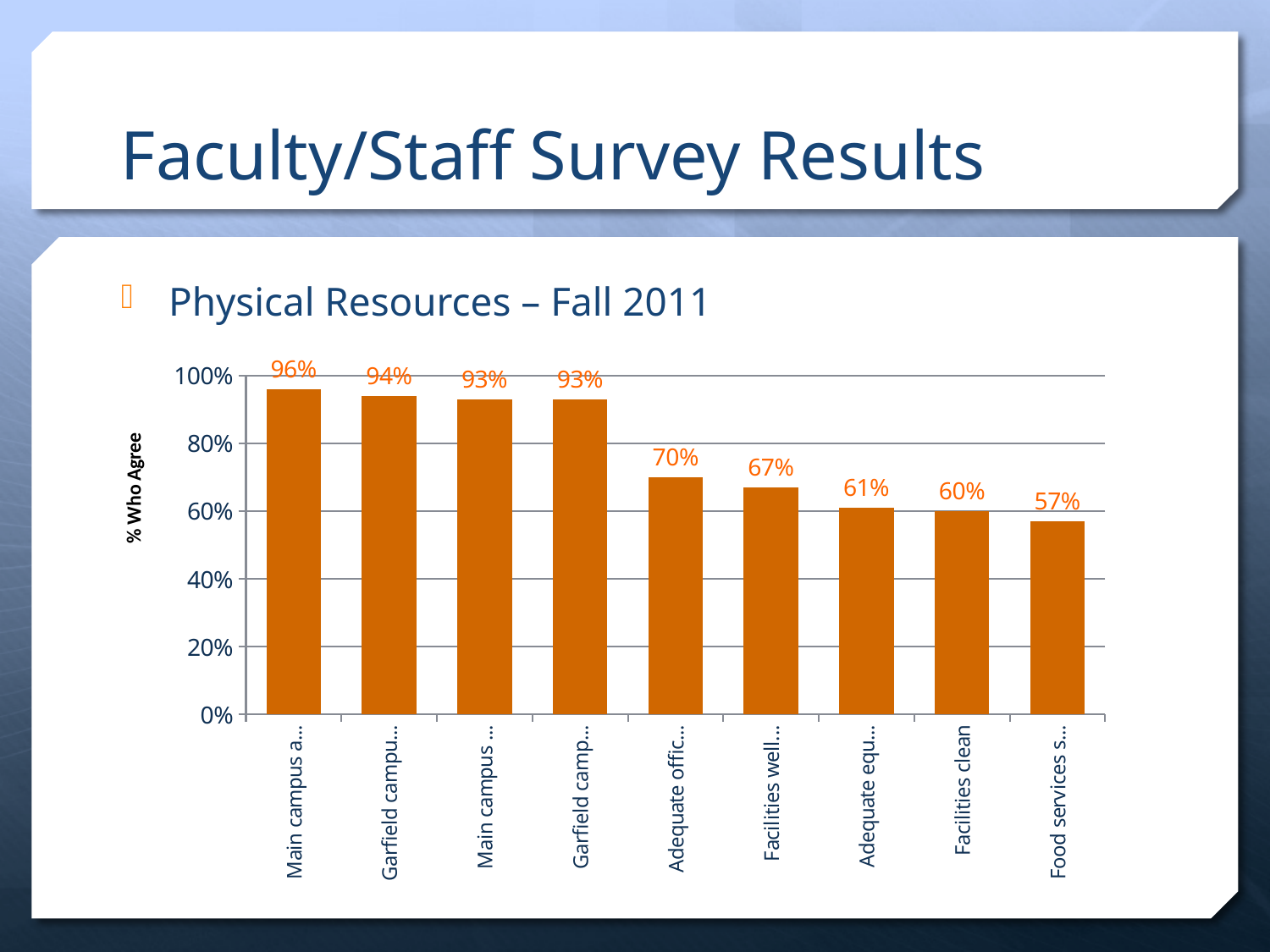
Which is larger: the value for "Facilities clean" or the value of the leftmost bar? the leftmost bar What is the lowest value shown in the chart? 57% What is the value for "Facilities clean"? 60% What is the value of the first (leftmost) bar in the chart? 96% How many bars (categories) does the chart show? 9 What kind of chart is shown on the slide? bar chart What is the value of the last (rightmost) bar in the chart? 57% What is the highest value shown in the chart? 96% What is the difference between the highest value (96%) and the lowest value (57%) in the chart? 39% Do the values generally rise or fall from left to right across the chart? fall What is the difference between the value for "Facilities clean" and the value of the rightmost bar? 3% What is the title of the vertical axis? % Who Agree